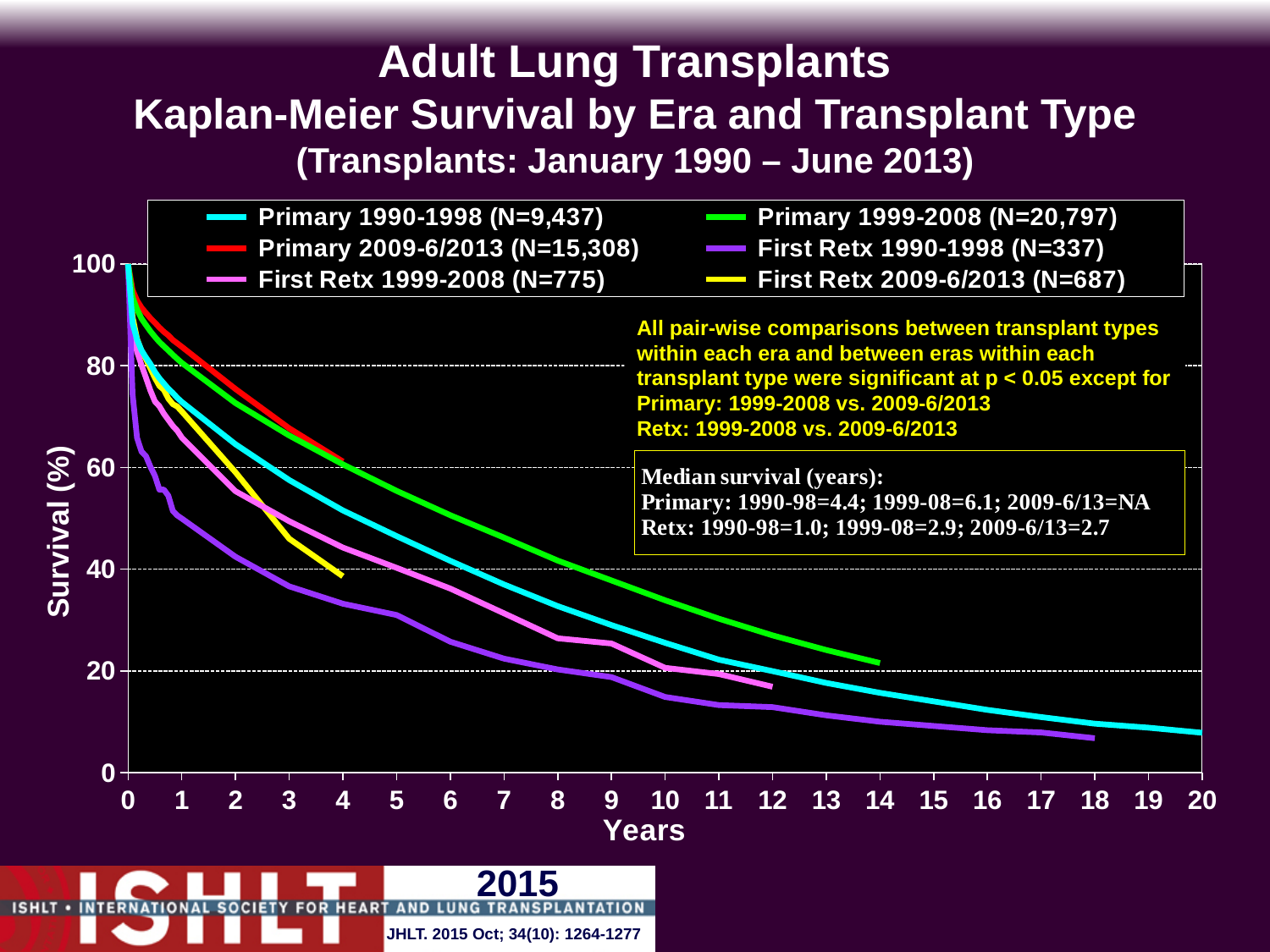
What is the difference in median survival (years) between Primary 1999-08 and Primary 1990-98? 1.7 How many series does the legend list? 6 At 5 years, which has higher survival: Primary 1999-2008 or First Retx 1990-1998? Primary 1999-2008 What kind of chart is shown on the slide? Line chart What is the N for the Primary 1999-2008 series? 20,797 What is the title of the chart? Adult Lung Transplants Kaplan-Meier Survival by Era and Transplant Type Do the survival curves rise or fall as years increase? Fall Is the survival for Primary 1999-2008 at 5 years greater or less than 40? greater What is the median survival in years for Primary transplants in 1990-98? 4.4 What is the median survival in years for Retx transplants in 1999-08? 2.9 What is the N for the First Retx 2009-6/2013 series? 687 Which group has the lowest median survival listed in the text box? Retx 1990-98 (1.0)